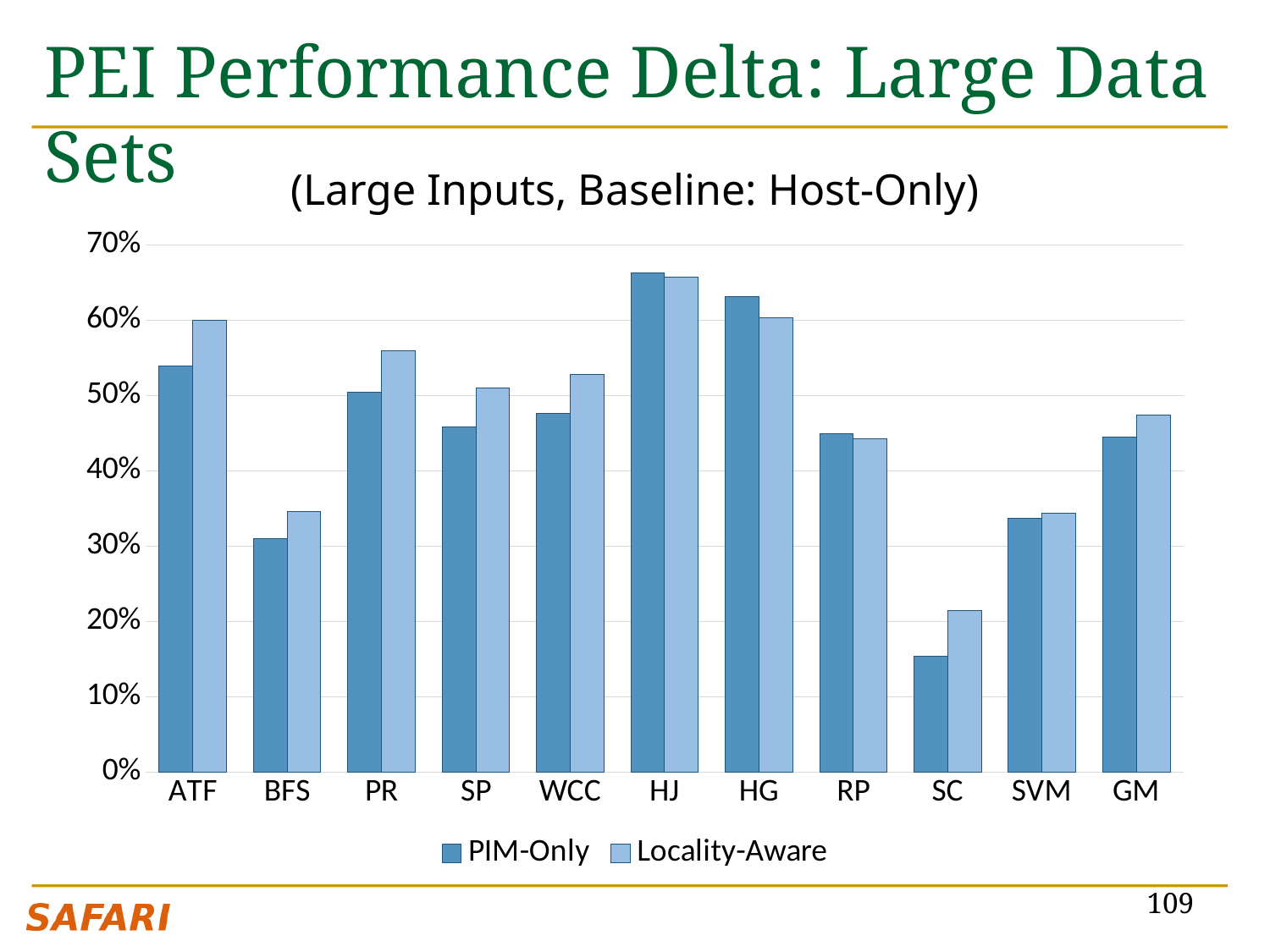
For HG, which is larger: the PIM-Only value or the Locality-Aware value? PIM-Only Which category has the highest PIM-Only value? HJ How many categories are shown on the x axis? 11 Is the PIM-Only value for SC greater or less than 20%? less Is the PIM-Only value for HG greater or less than 60%? greater What are the two series named in the legend? PIM-Only and Locality-Aware For ATF, which is larger: the PIM-Only value or the Locality-Aware value? Locality-Aware Which category has the lowest Locality-Aware value? SC What kind of chart is shown on the slide? bar chart Is the PIM-Only value for ATF greater or less than 50%? greater How many series does the legend list? 2 Which category has the lowest PIM-Only value? SC